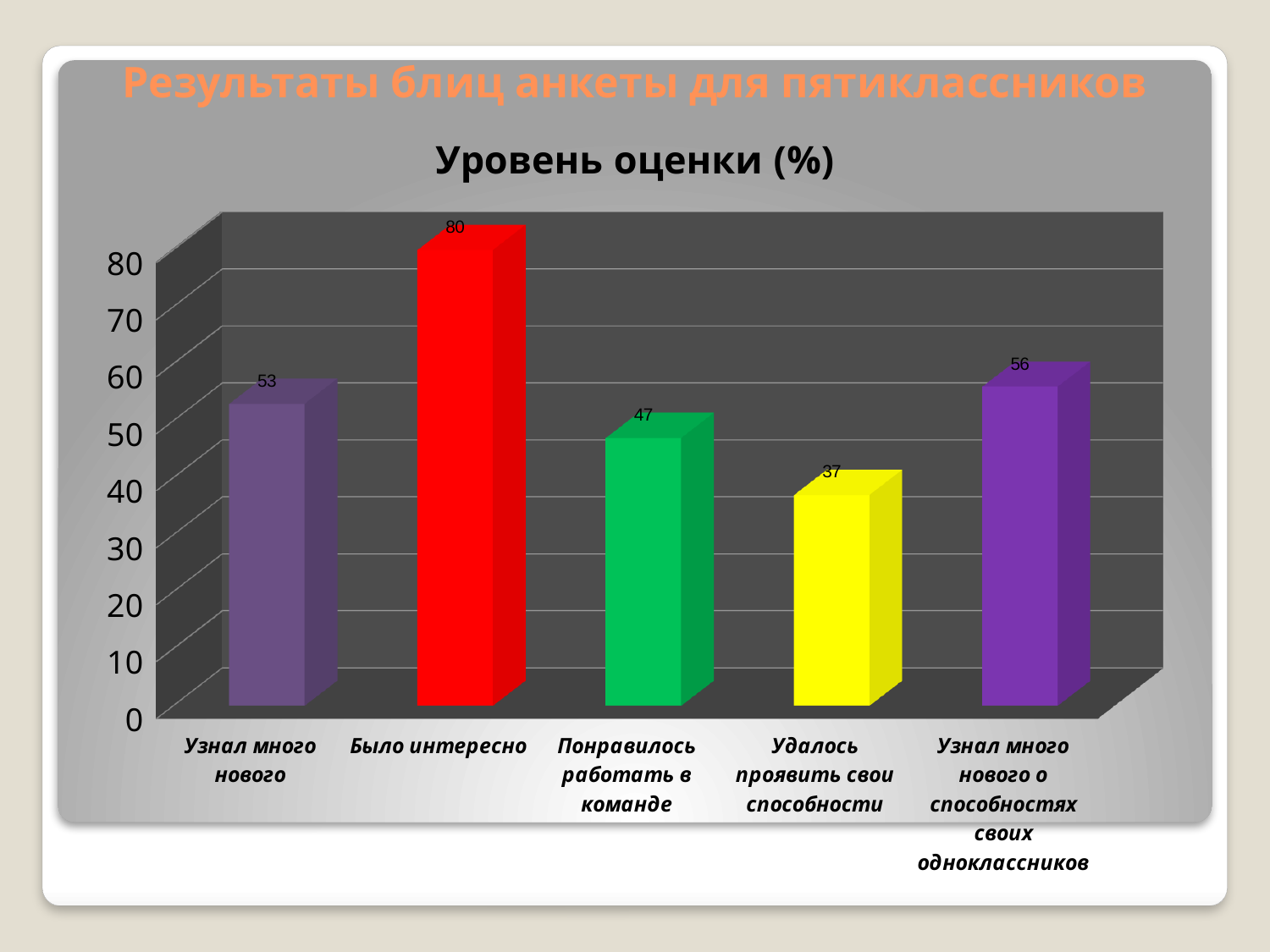
What is the value for "Было интересно"? 80 What is the value for "Узнал много нового"? 53 What is the value for "Удалось проявить свои способности"? 37 What is the value for "Понравилось работать в команде"? 47 Which category has the lowest value? Удалось проявить свои способности Which is larger: the value for "Узнал много нового" or the value for "Узнал много нового о способностях своих одноклассников"? Узнал много нового о способностях своих одноклассников Is the value for "Понравилось работать в команде" greater or less than 50? less How many categories are shown in the chart? 5 Which category has the highest value? Было интересно What is the title of the chart? Уровень оценки (%) What kind of chart is shown on the slide? bar chart What is the difference between the values for "Было интересно" and "Удалось проявить свои способности"? 43